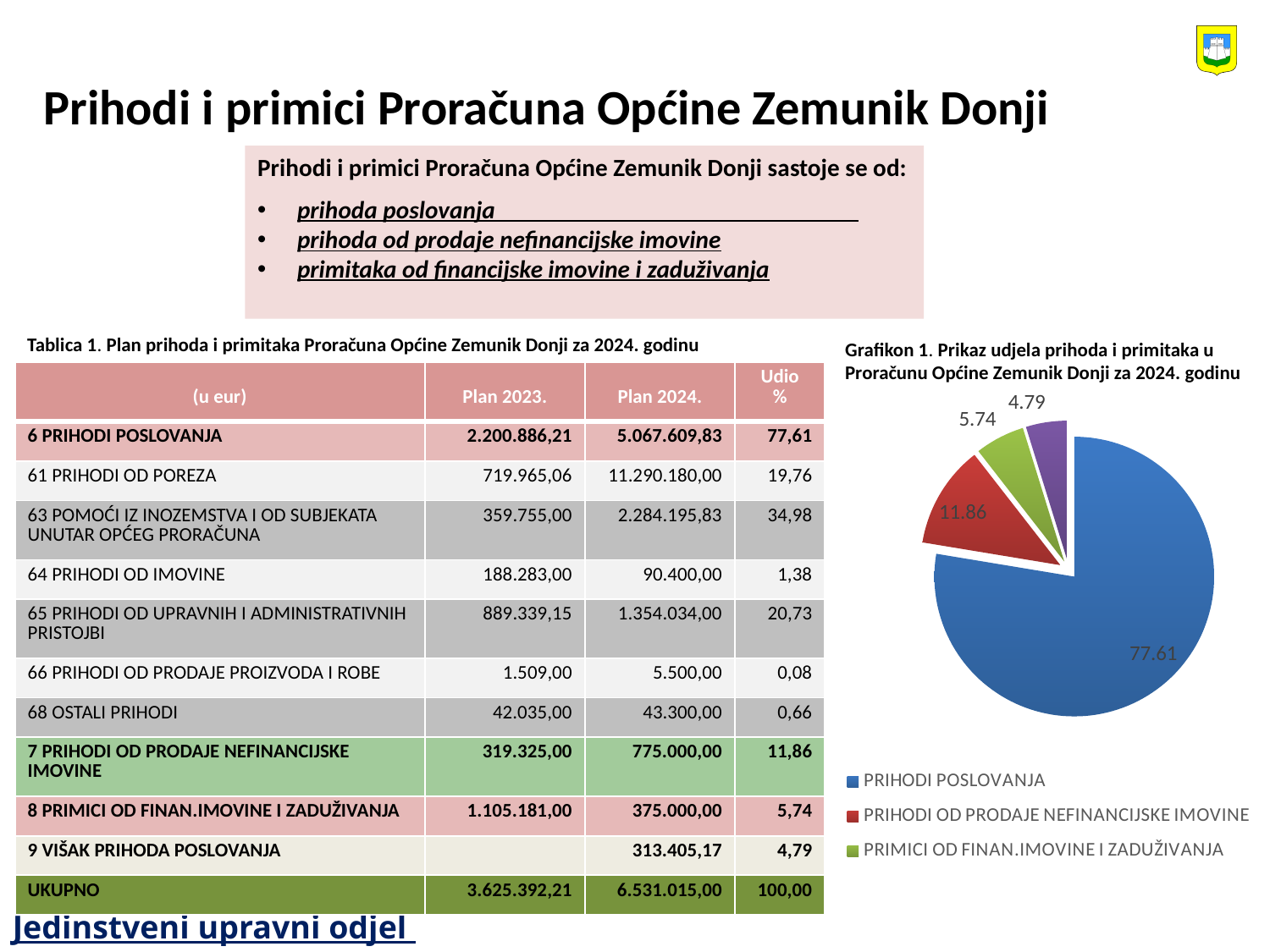
What is the smallest value labelled on the pie chart? 4.79 What kind of chart is Grafikon 1 on the slide? pie chart How many entries does the legend of the pie chart list? 3 Which category has the largest slice in the pie chart? PRIHODI POSLOVANJA In the pie chart, what value is shown for PRIMICI OD FINAN.IMOVINE I ZADUŽIVANJA? 5.74 How many slices does the pie chart have? 4 In the pie chart, which is larger: PRIHODI OD PRODAJE NEFINANCIJSKE IMOVINE or PRIMICI OD FINAN.IMOVINE I ZADUŽIVANJA? PRIHODI OD PRODAJE NEFINANCIJSKE IMOVINE In the pie chart, what value is shown for PRIHODI POSLOVANJA? 77.61 What is the title of the pie chart on the slide? Grafikon 1. Prikaz udjela prihoda i primitaka u Proračunu Općine Zemunik Donji za 2024. godinu In the pie chart, what value is shown for PRIHODI OD PRODAJE NEFINANCIJSKE IMOVINE? 11.86 What colour is the PRIHODI POSLOVANJA slice in the pie chart? blue What is the difference between the pie chart values for PRIHODI POSLOVANJA and PRIHODI OD PRODAJE NEFINANCIJSKE IMOVINE? 65.75